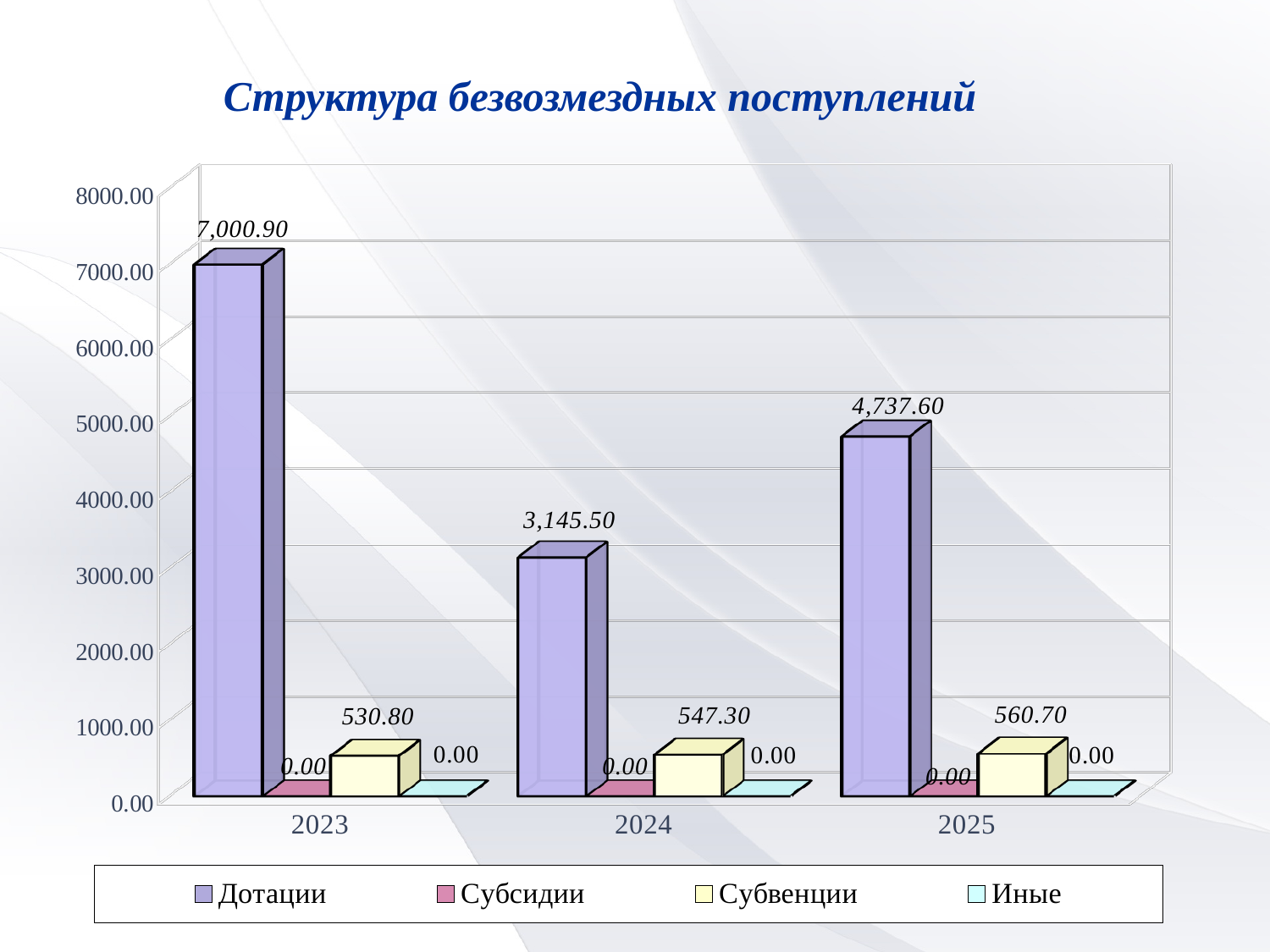
How many series does the legend list? 4 What is the value of Дотации for 2023? 7,000.90 Is the value of Дотации for 2025 greater or less than 4000.00? greater What is the title of the chart? Структура безвозмездных поступлений Which is larger: Субвенции in 2024 or Субвенции in 2023? Субвенции in 2024 In which year is the Дотации value the highest? 2023 What is the difference between the Дотации values for 2023 and 2025? 2,263.30 How many years are shown on the x axis? 3 What is the value of Субвенции for 2025? 560.70 What kind of chart is shown on the slide? bar chart In which year is the Дотации value the lowest? 2024 What is the value of Дотации for 2024? 3,145.50